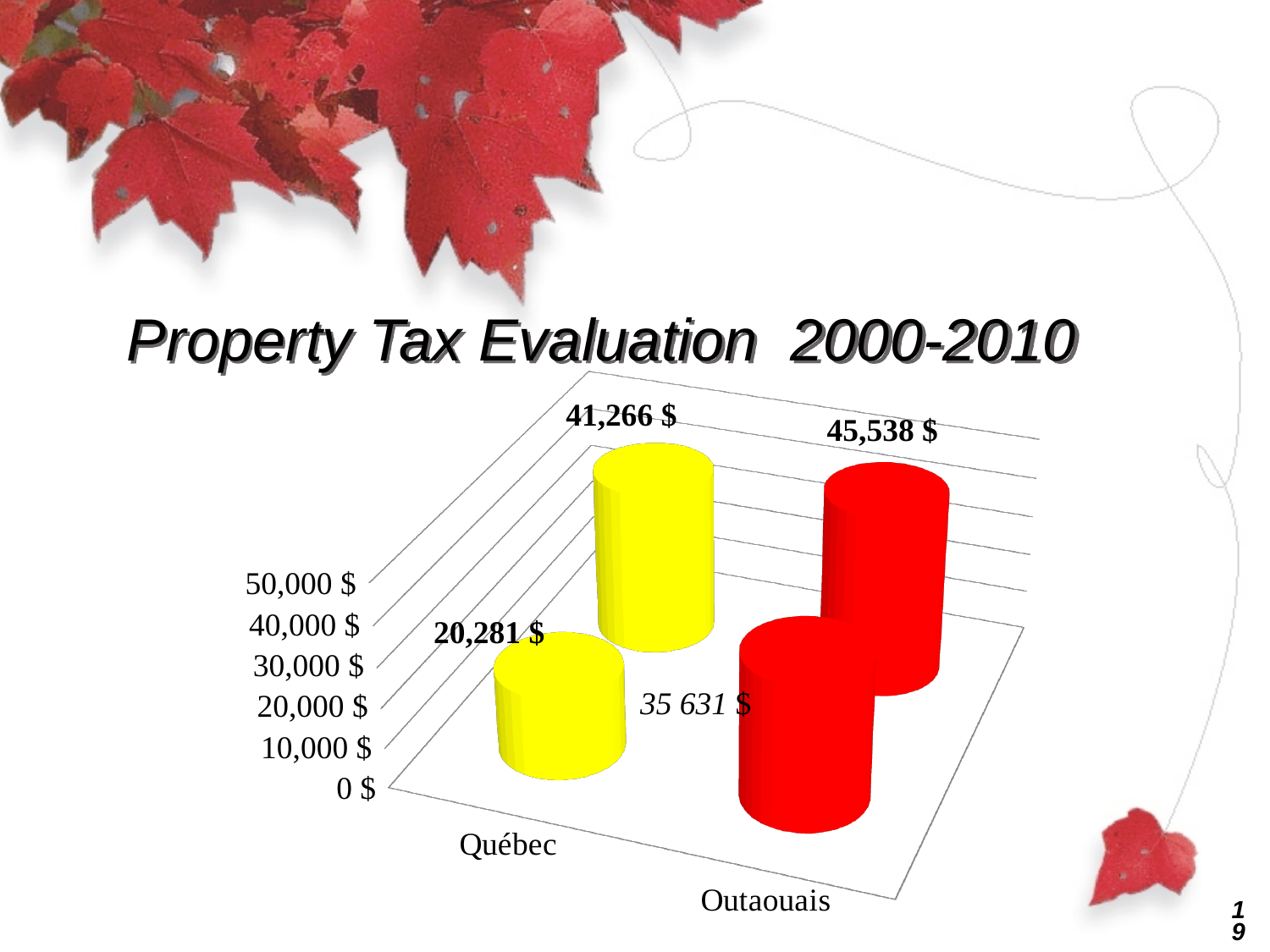
How many categories are shown on the x axis of the chart? 2 What is the value of the back (taller) bar for Québec? 41,266 $ What is the value of the back (taller) bar for Outaouais? 45,538 $ What is the value of the front (shorter) bar for Outaouais? 35 631 $ Which category has the highest labeled value on the chart? Outaouais What is the value of the front (shorter) bar for Québec? 20,281 $ Which category has the lowest labeled value on the chart? Québec What is the title of the chart? Property Tax Evaluation 2000-2010 Is the value of the front bar for Québec greater or less than 30,000 $? less What is the difference between the back bar values for Outaouais (45,538 $) and Québec (41,266 $)? 4,272 $ Which is larger: the front bar for Québec or the front bar for Outaouais? Outaouais What kind of chart is shown on the slide? bar chart